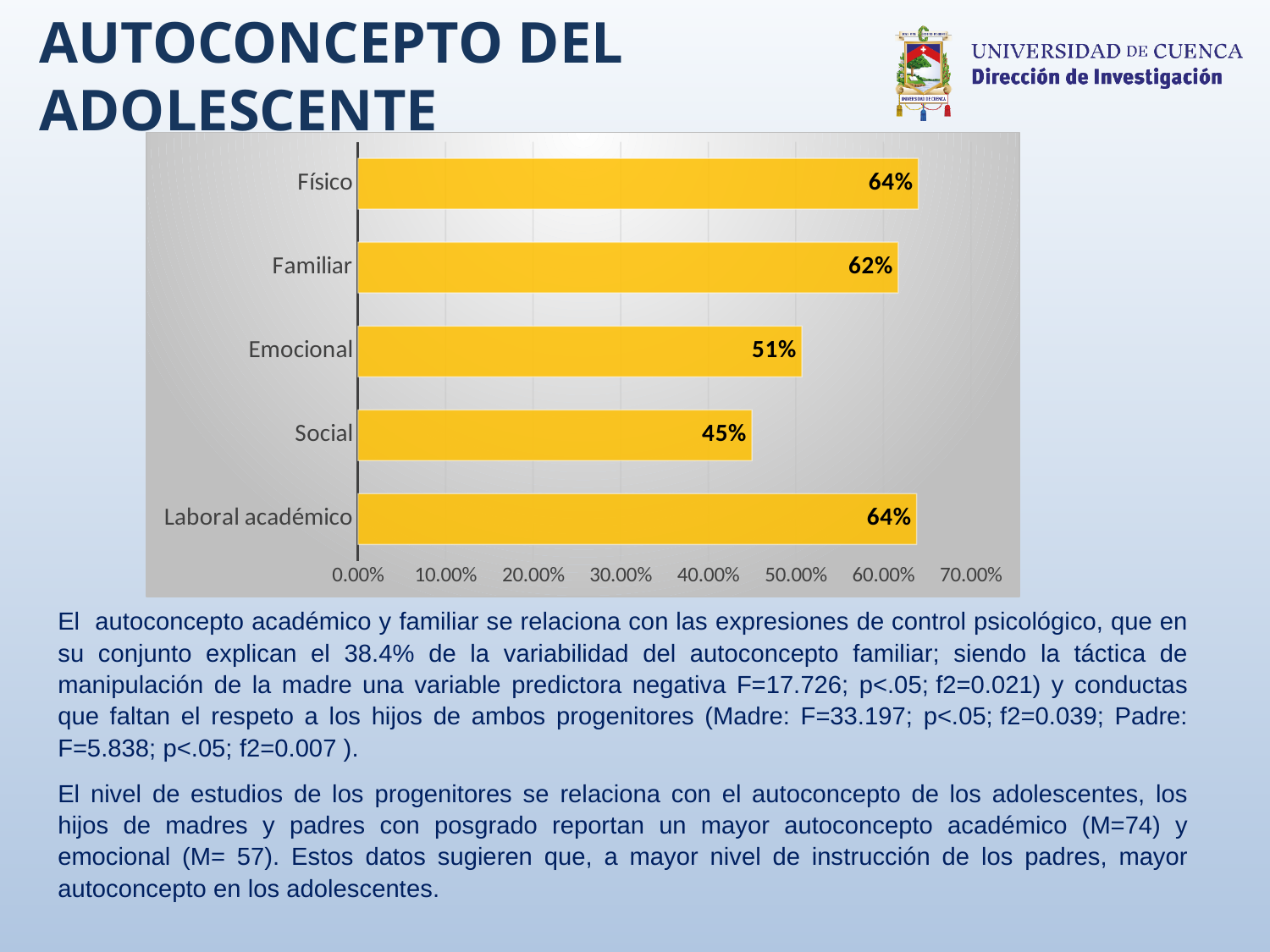
What is the value for Familiar? 62% Which category has the lowest value? Social Which is larger, the value for Familiar or the value for Emocional? Familiar What is the value for Emocional? 51% What is the highest value shown on the x axis? 70.00% What is the value for Social? 45% What colour are the bars in the chart? yellow What is the difference between the values for Físico and Social? 19% How many categories are shown in the chart? 5 What kind of chart is shown on the slide? bar chart What is the difference between the values for Familiar and Emocional? 11% Is the value for Social greater or less than 50.00%? less